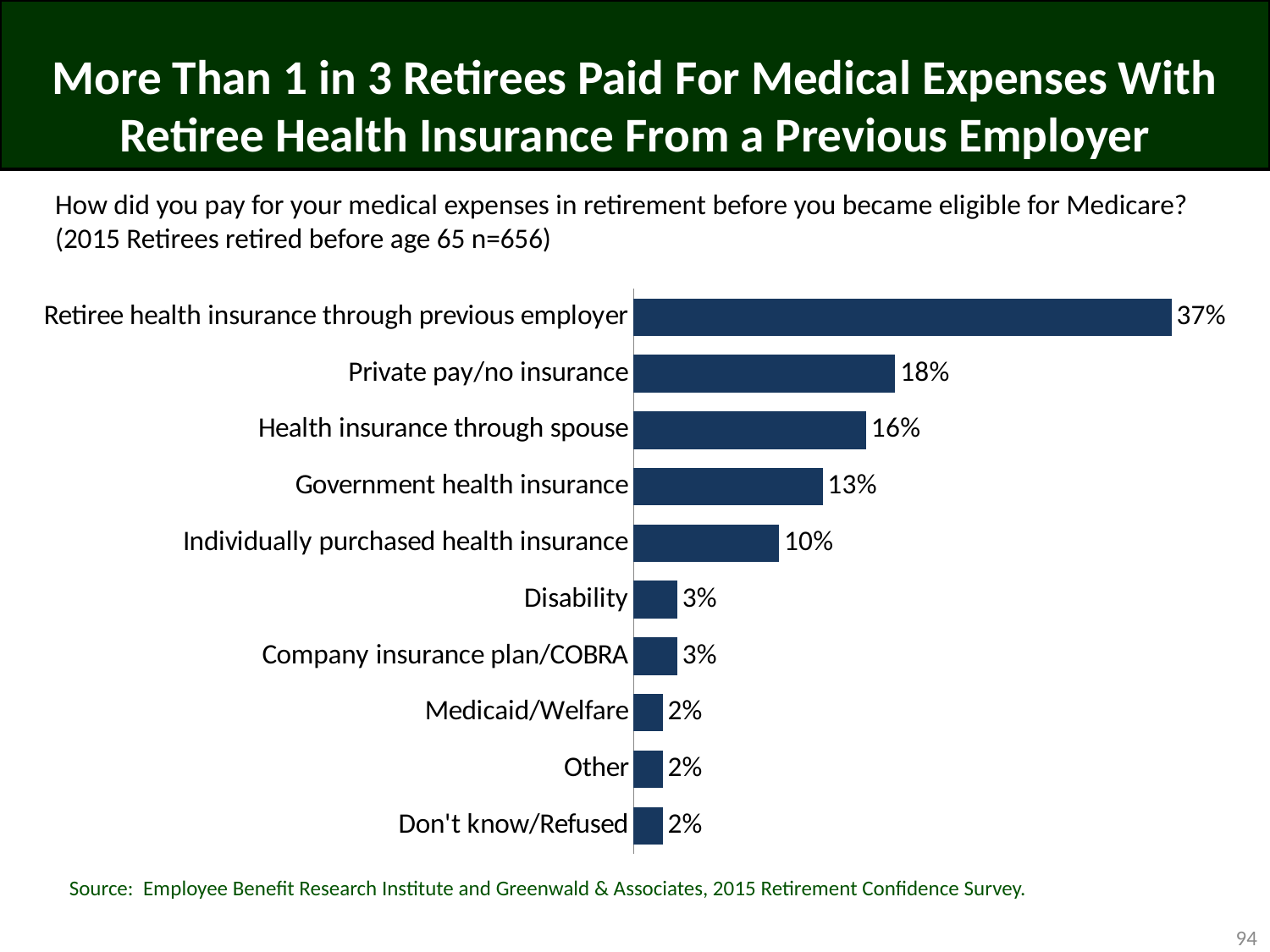
What kind of chart is shown on the slide? Bar chart What is the difference between Private pay/no insurance and Health insurance through spouse? 2% What percentage of retirees paid for medical expenses with retiree health insurance through a previous employer? 37% What is the value for Government health insurance? 13% What is the value for Private pay/no insurance? 18% What is the sample size (n) stated in the chart's subtitle? 656 What is the value for Medicaid/Welfare? 2% What is the value for Individually purchased health insurance? 10% Which category has the highest value? Retiree health insurance through previous employer Which is larger, Health insurance through spouse or Individually purchased health insurance? Health insurance through spouse How many categories are shown in the chart? 10 What is the difference between Retiree health insurance through previous employer and Government health insurance? 24%